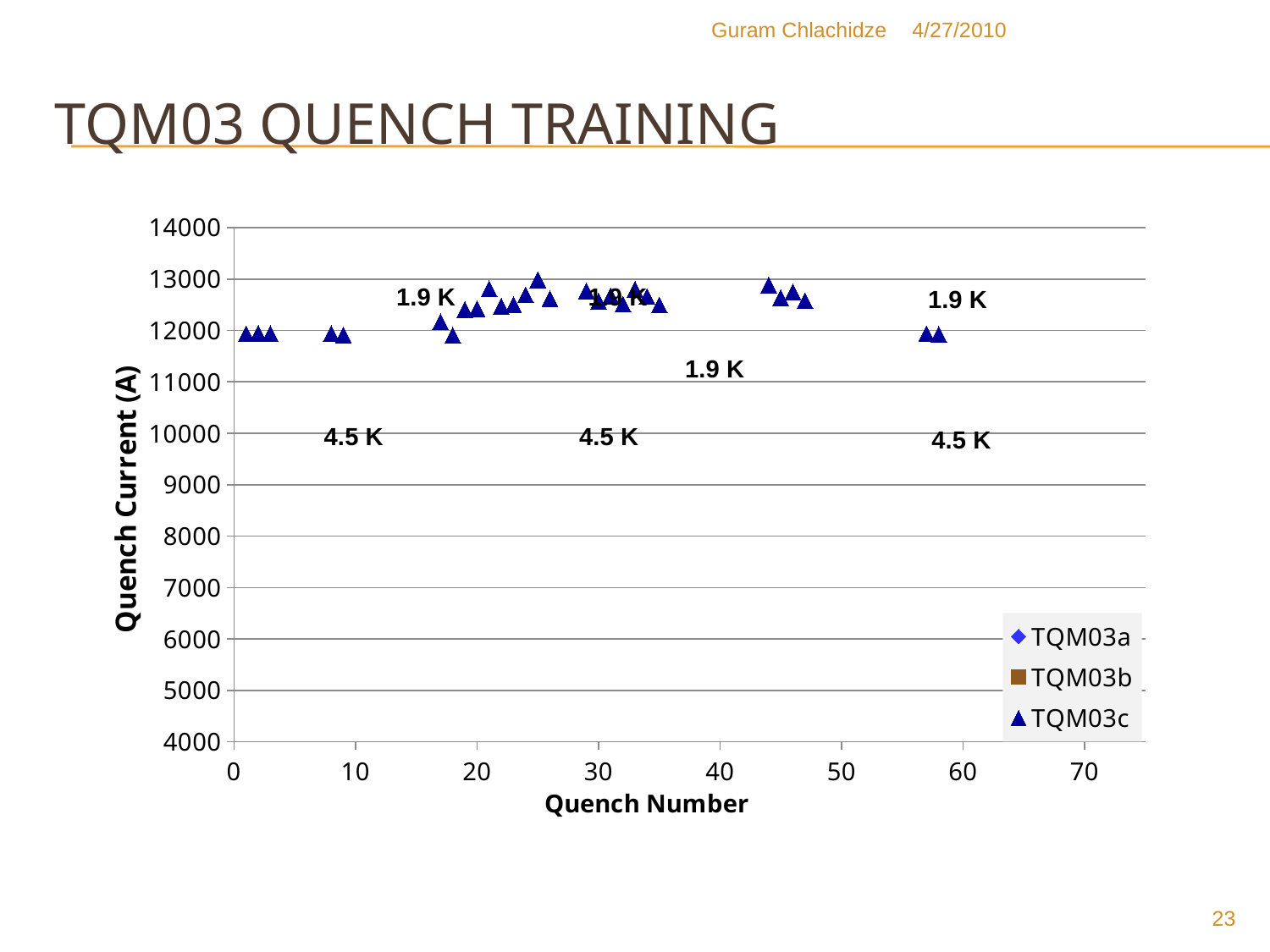
What is the title of the vertical axis? Quench Current (A) Are all plotted quench currents greater or less than 11000? greater Is the quench current at quench number 57 greater or less than 12500? less Between quench number 17 and quench number 25, do the quench currents generally rise or fall? rise How many series does the legend list? 3 Is the quench current at quench number 1 greater or less than 13000? less Which legend series uses a triangle marker? TQM03c What kind of chart is shown on the slide? scatter chart Is the quench current at quench number 44 larger or smaller than the quench current at quench number 58? larger